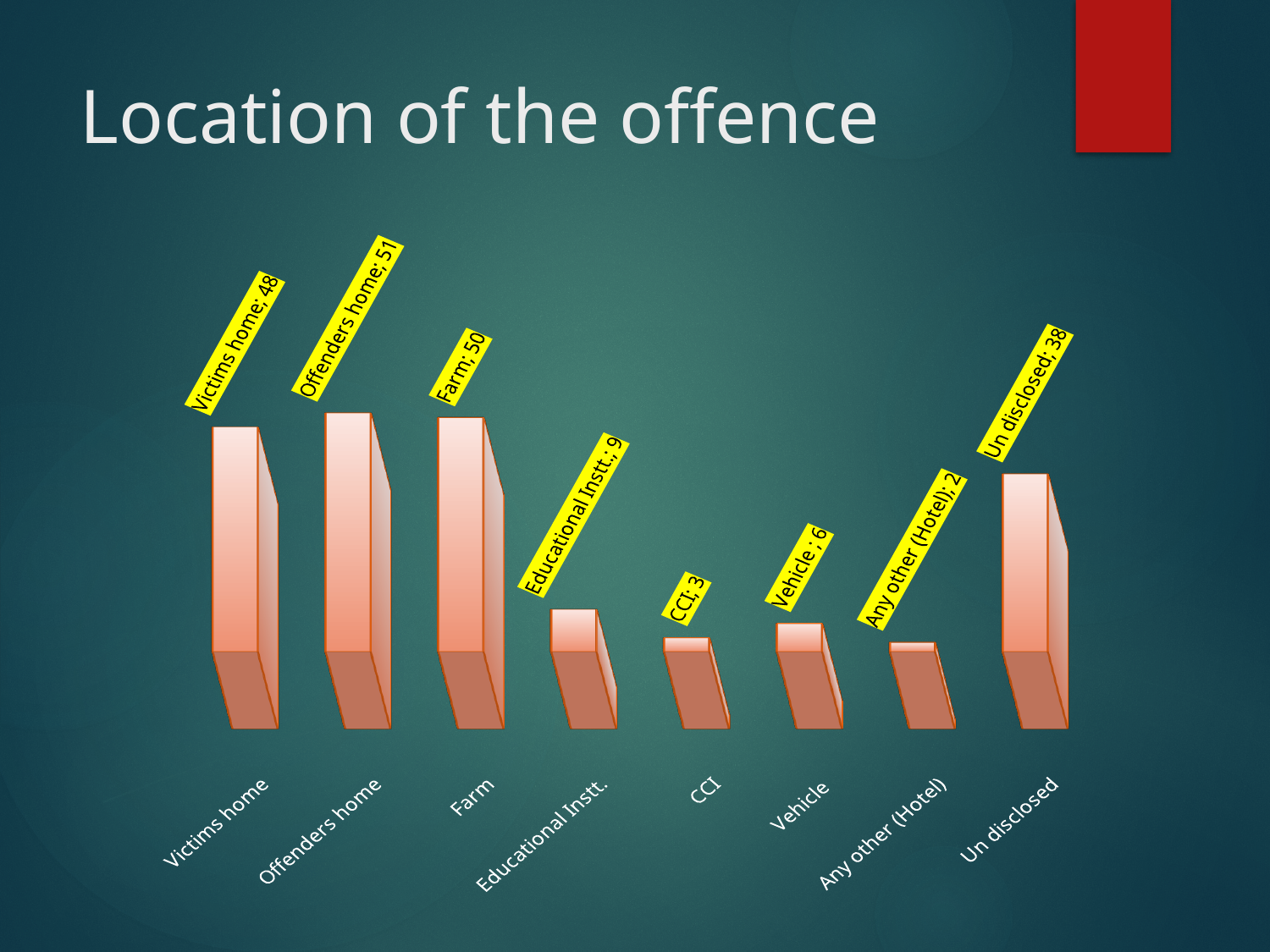
What is the value for Offenders home? 51 What is the value for Vehicle? 6 Which category has the highest value? Offenders home What kind of chart is shown on the slide? Bar chart What is the value for Farm? 50 What is the difference between the values for Offenders home and Victims home? 3 Which category has the lowest value? Any other (Hotel) How many categories are shown in the chart? 8 What is the value for Un disclosed? 38 Which is larger, the value for Educational Instt. or the value for CCI? Educational Instt. What is the value for Victims home? 48 What is the difference between the values for Farm and Un disclosed? 12